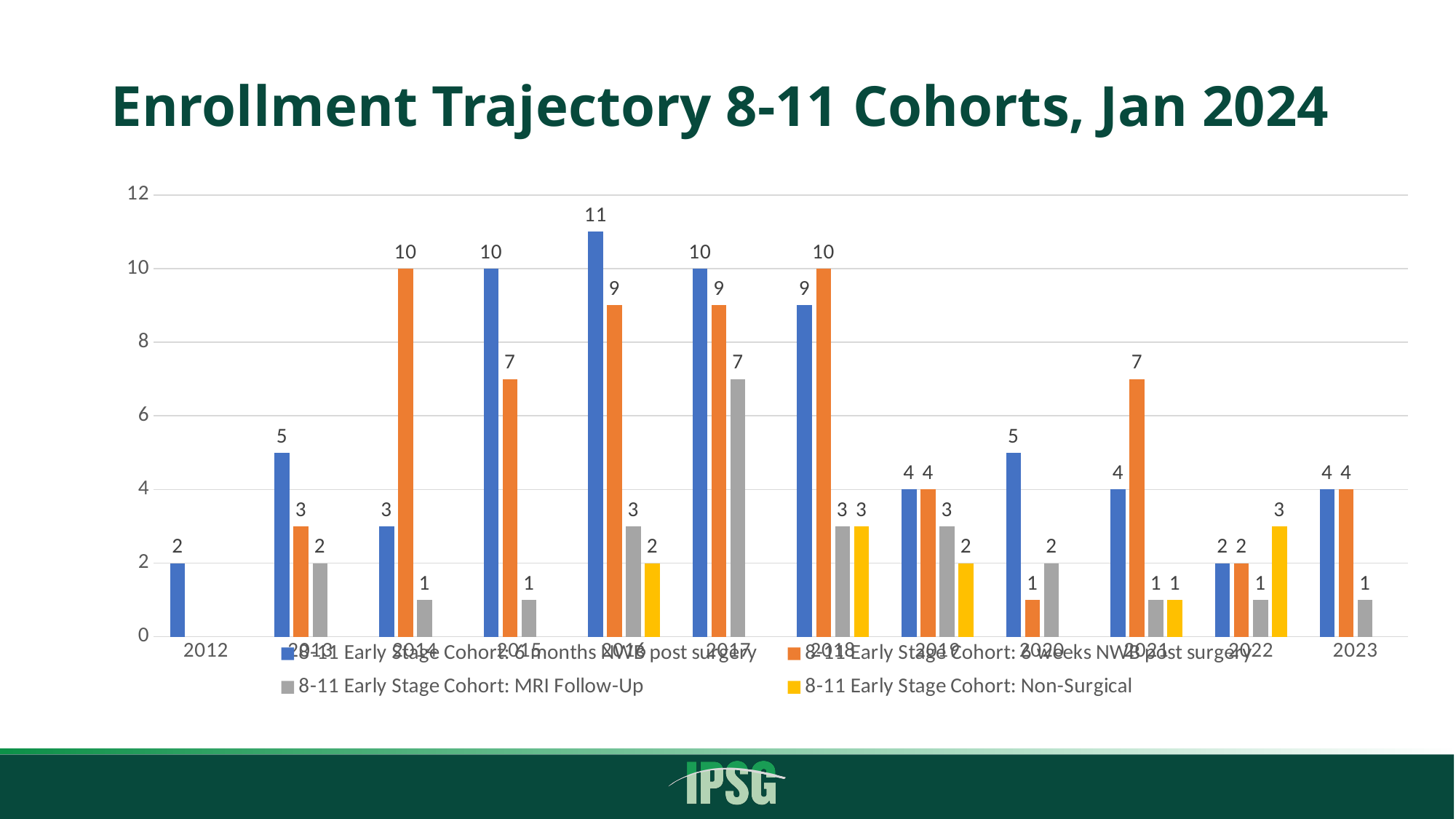
What is the title of the chart? Enrollment Trajectory 8-11 Cohorts, Jan 2024 How many years are shown along the x axis? 12 In which year does the blue series reach its highest value? 2016 What kind of chart is shown on the slide? Bar chart What is the value of the orange series in 2021? 7 In 2020, which is larger, the blue bar or the orange bar? The blue bar In 2014, how much larger is the orange bar than the blue bar? 7 In which year does the MRI Follow-Up series (gray bars) reach its highest value? 2017 What is the value of the blue series in 2012? 2 What is the value of the MRI Follow-Up series (gray bars) in 2017? 7 What is the value of the Non-Surgical series (yellow bars) in 2022? 3 How many series does the legend list? 4